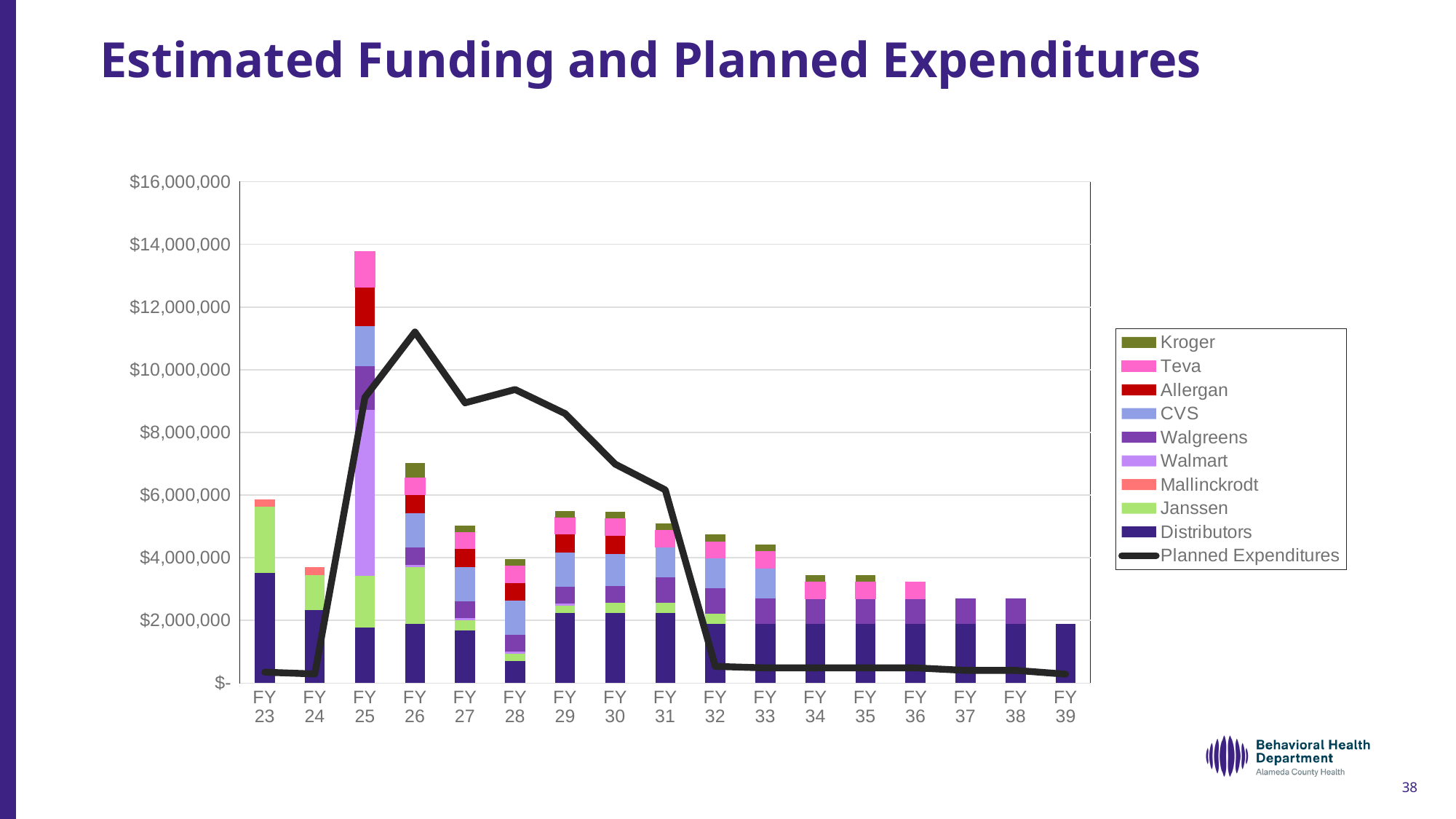
Which legend entry is plotted as a line rather than as stacked bars? Planned Expenditures Is the Planned Expenditures value for FY 26 greater or less than $10,000,000? greater Which is larger, the Planned Expenditures value for FY 26 or for FY 27? FY 26 Is the Planned Expenditures value for FY 32 greater or less than $2,000,000? less How many fiscal years are shown along the x axis? 17 Is the total stacked bar for FY 37 greater or less than $2,000,000? greater Which fiscal year has the shortest stacked bar? FY 39 Does the Planned Expenditures line rise or fall from FY 26 to FY 32? Fall What kind of chart is shown on the slide? A stacked bar chart with a line overlay How many entries does the legend list? 10 Which fiscal year has the tallest stacked bar? FY 25